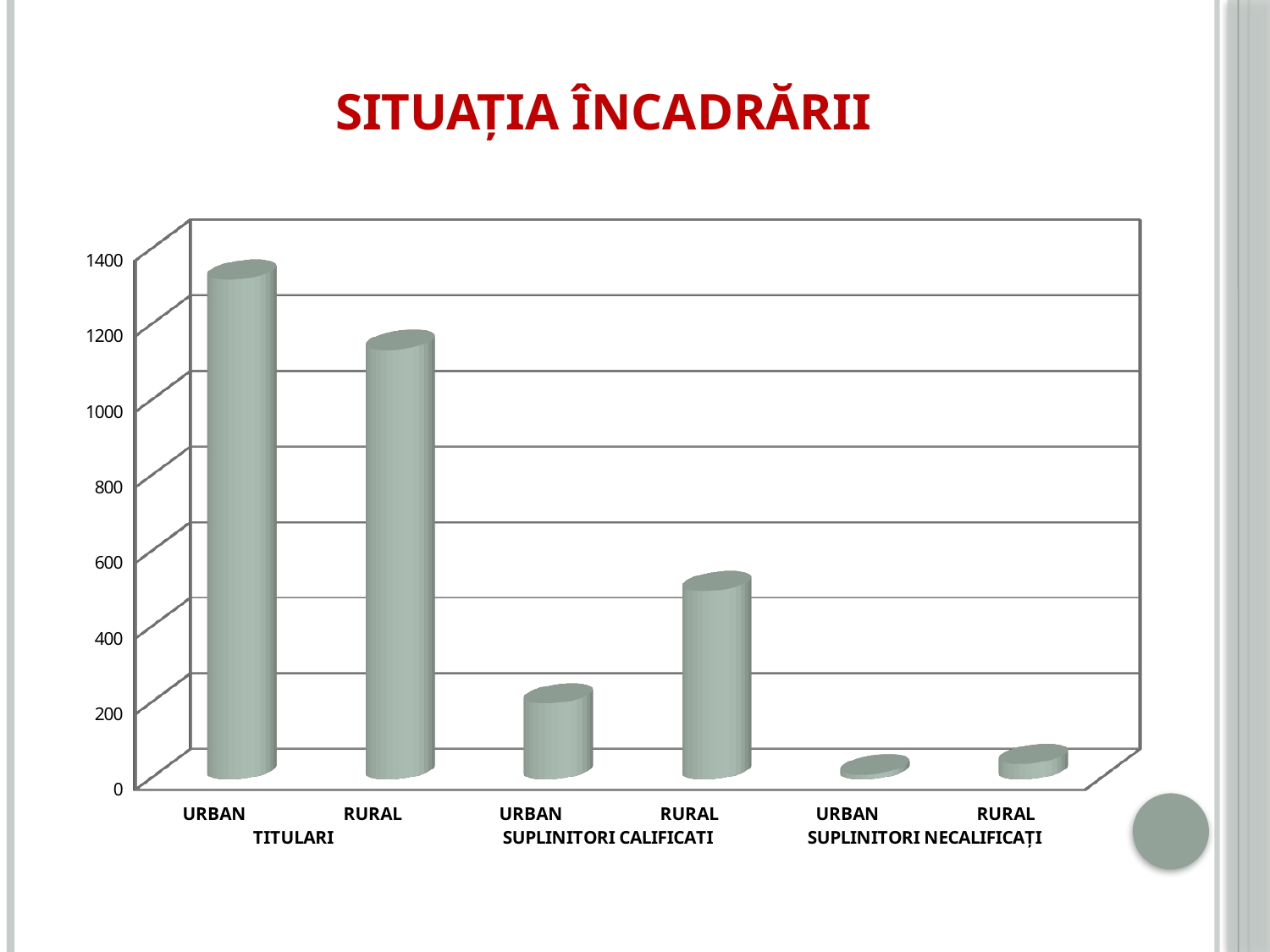
Is the value for RURAL under SUPLINITORI NECALIFICAȚI greater or less than 200? less Which bar is the lowest in the chart? URBAN (SUPLINITORI NECALIFICAȚI) Which is larger: the RURAL bar under TITULARI or the RURAL bar under SUPLINITORI CALIFICATI? RURAL under TITULARI Is the value for RURAL under TITULARI greater or less than 1000? greater Which bar is the highest in the chart? URBAN (TITULARI) Is the value for RURAL under SUPLINITORI CALIFICATI greater or less than 400? greater What kind of chart is shown on the slide? bar chart What is the title of the slide? SITUAȚIA ÎNCADRĂRII How many bars are plotted in the chart? 6 Within SUPLINITORI CALIFICATI, which is larger, URBAN or RURAL? RURAL